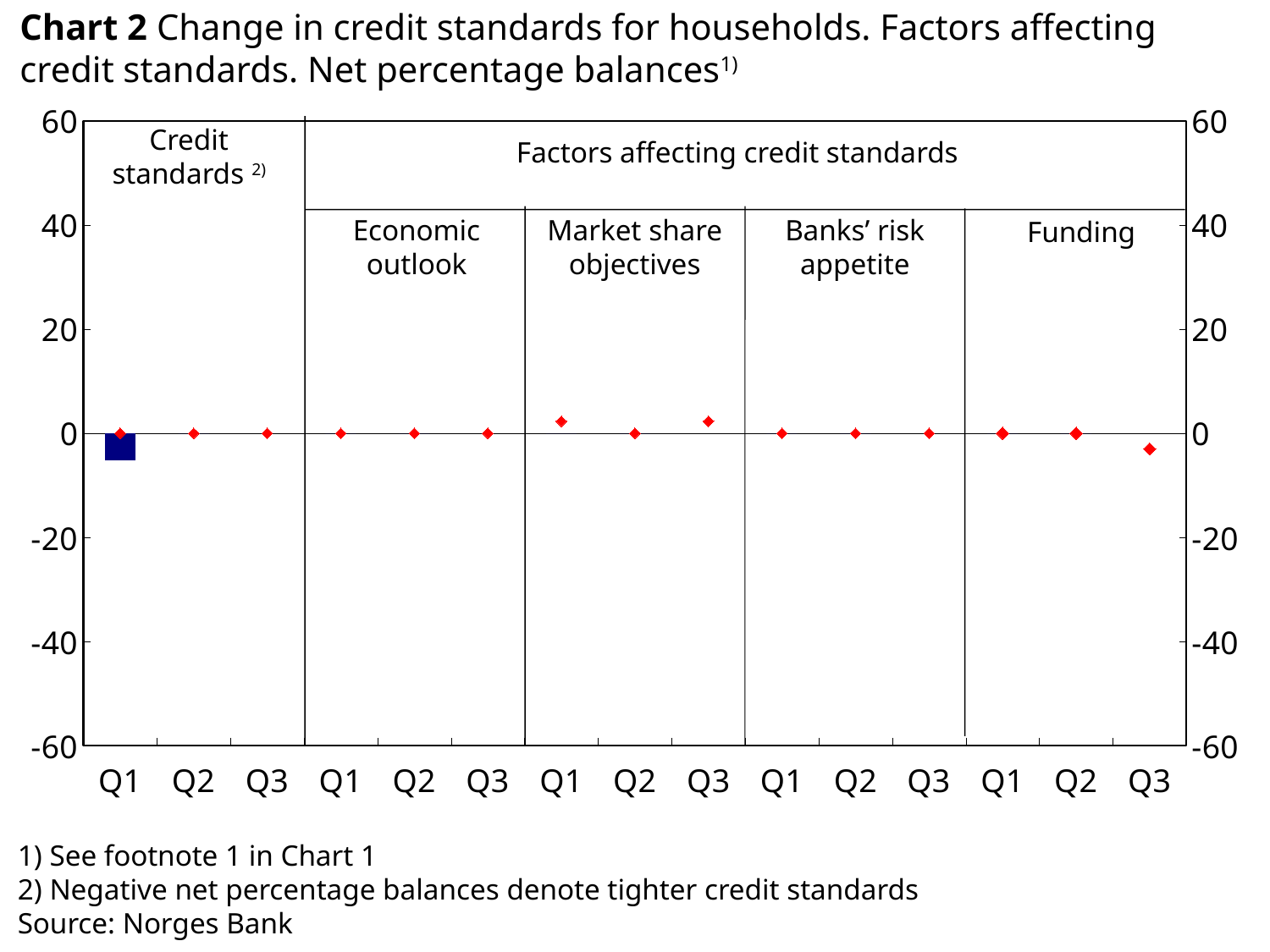
Is the value for Credit standards in Q1 greater or less than 0? less What is the source given for the chart? Norges Bank What is the highest value shown on the vertical axis? 60 Is the value for Market share objectives in Q3 greater or less than 20? less Which is larger, the value for Funding in Q3 or the value for Market share objectives in Q3? Market share objectives in Q3 Is the value for Credit standards in Q1 greater or less than -20? greater How many factors affecting credit standards are shown in the chart? 4 Which is larger, the value for Credit standards in Q1 or the value for Credit standards in Q2? Credit standards in Q2 How many quarters are shown for each panel of the chart? 3 Within the Funding panel, do the values rise or fall from Q1 to Q3? fall